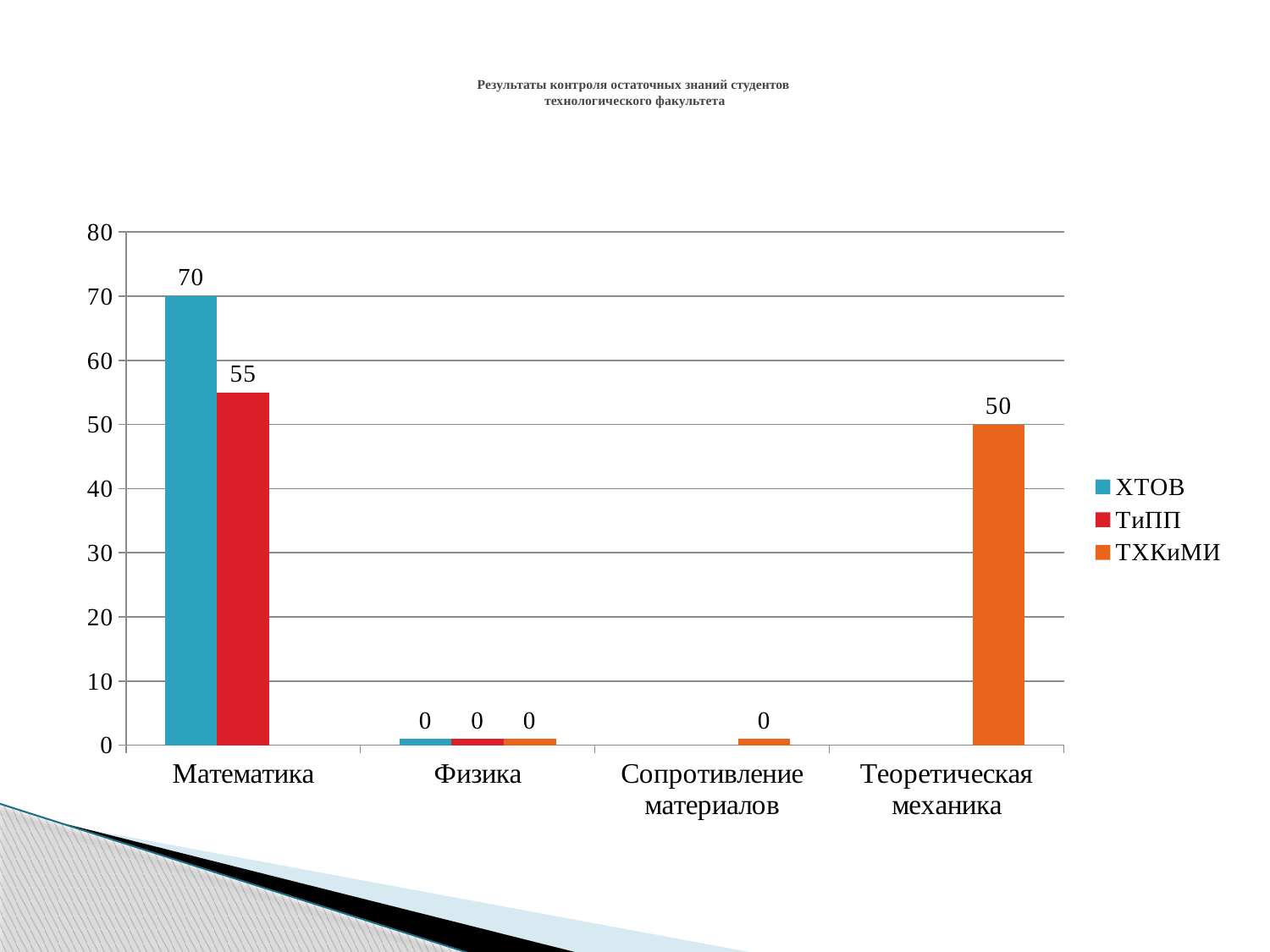
How many categories are shown on the x axis? 4 What colour represents ТХКиМИ in the legend? orange Which series has the highest value on the chart? ХТОВ How many series does the legend list? 3 What kind of chart is shown on the slide? bar chart What is the value for ХТОВ in Математика? 70 What is the difference between the ХТОВ and ТиПП values in Математика? 15 What is the value for ТиПП in Математика? 55 What is the value for ТХКиМИ in Теоретическая механика? 50 Is the value for ТХКиМИ in Теоретическая механика greater or less than 40? greater Which is larger in Математика: ХТОВ or ТиПП? ХТОВ What is the value for ТХКиМИ in Сопротивление материалов? 0